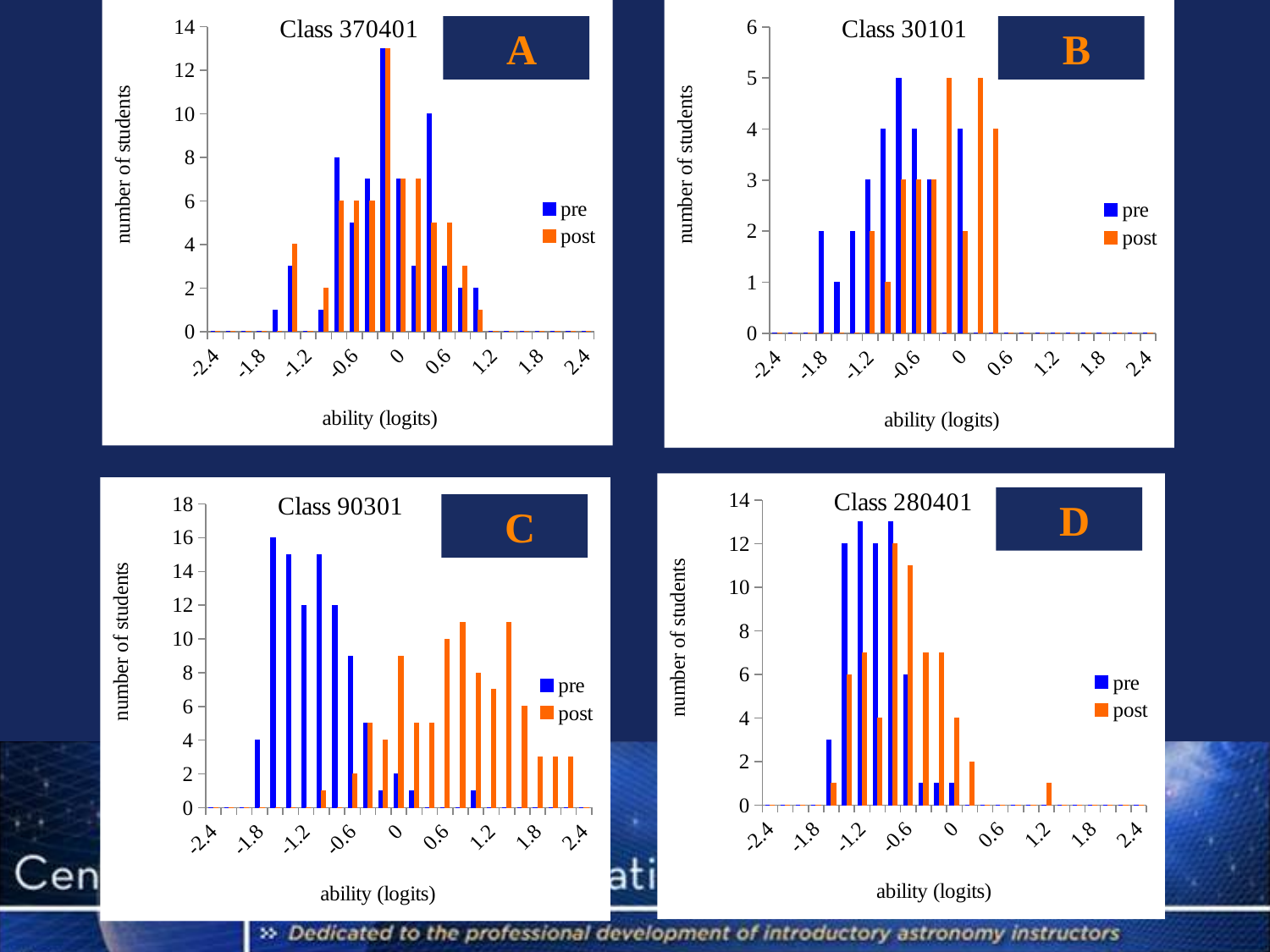
In the Class 370401 chart (chart A), is the tallest pre bar greater or less than 12? greater In the Class 90301 chart (chart C), is the tallest post bar greater or less than 12? less What is the x-axis label on the Class 30101 chart (chart B)? ability (logits) In the Class 30101 chart (chart B), how many students does the tallest post bar reach? 5 In the Class 280401 chart (chart D), is the tallest pre bar greater or less than 12? greater In the Class 90301 chart (chart C), which series has the tallest bar, pre or post? pre How many series does the legend list in the Class 30101 chart (chart B)? 2 In the Class 30101 chart (chart B), how many students does the tallest pre bar reach? 5 In the Class 90301 chart (chart C), how many students does the tallest pre bar reach? 16 What are the two legend entries in the Class 90301 chart (chart C)? pre and post What kind of chart is used for Class 370401 (chart A)? bar chart